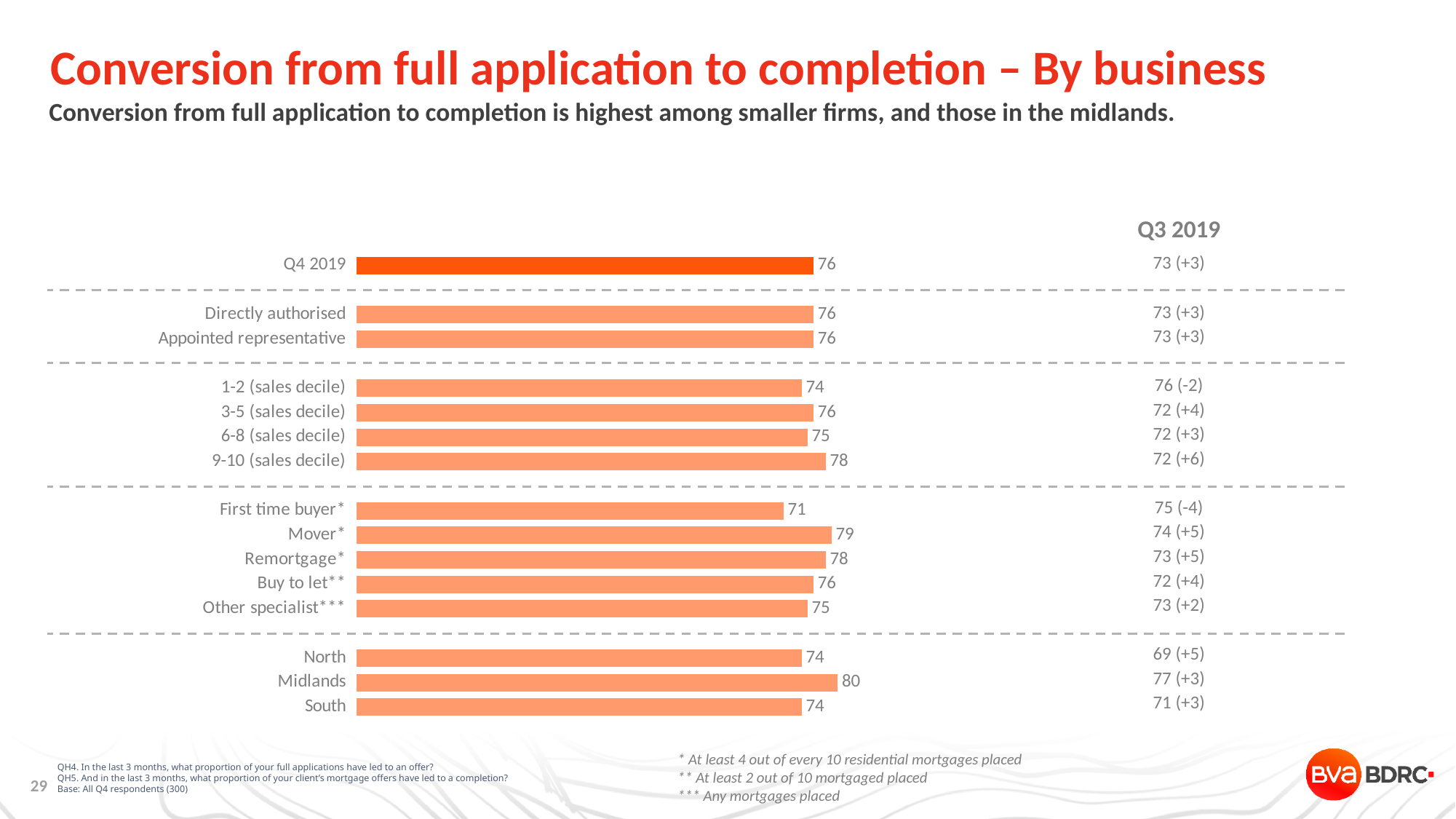
What is the value for First time buyer? 71 What is the Q3 2019 value shown for North? 69 (+5) Which category has the lowest value? First time buyer What is the difference between the values for Midlands and North? 6 Which category has the highest value? Midlands How many bars are plotted in the chart? 16 What is the value for Midlands? 80 Which is larger, the value for Mover or the value for Remortgage? Mover What is the value for the overall Q4 2019 bar? 76 What is the difference between the values for Mover and First time buyer? 8 What is the value for 9-10 (sales decile)? 78 What kind of chart is shown on the slide? Bar chart